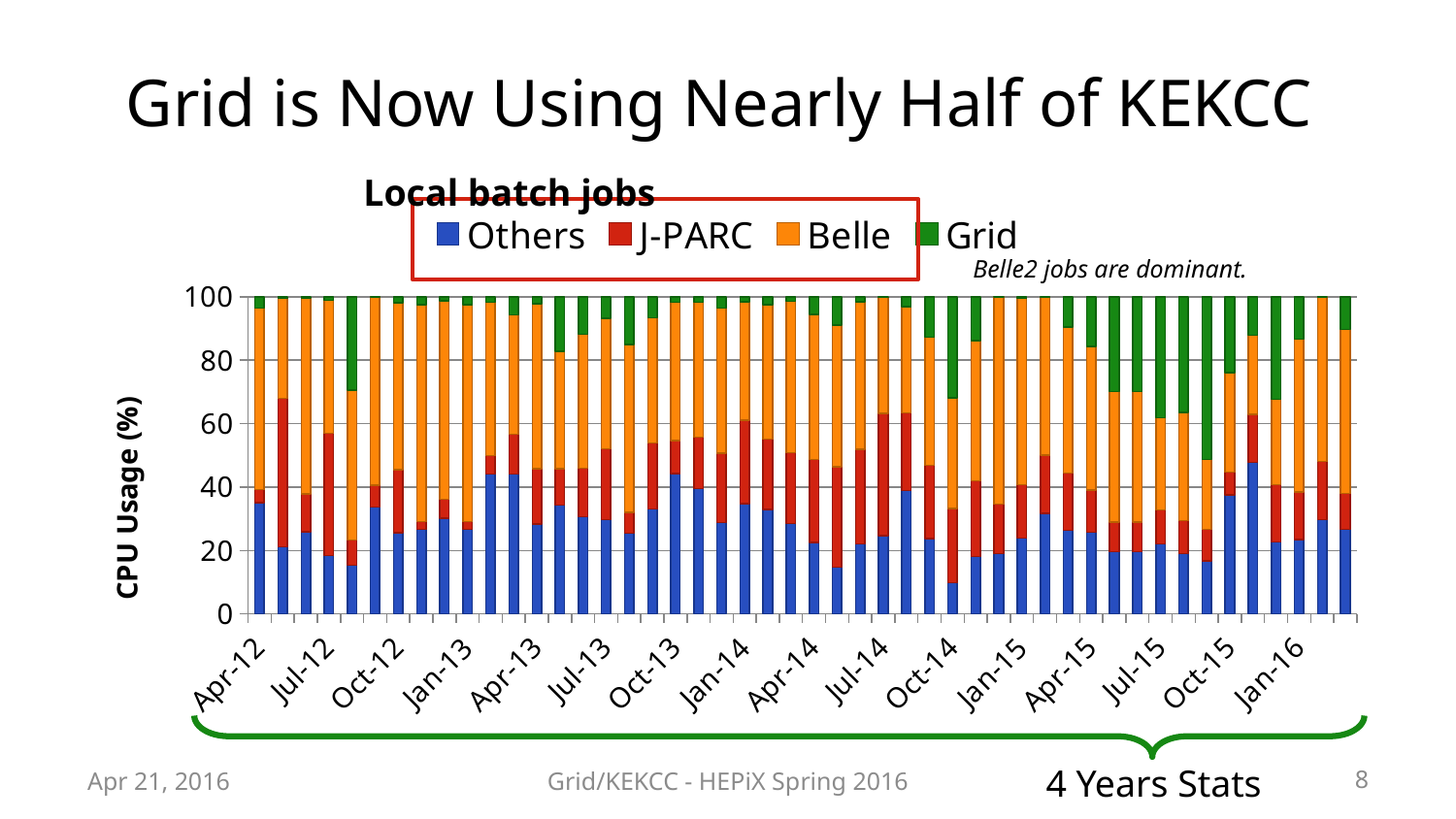
Does the Grid share generally rise or fall from Apr-12 to Jan-16? rise What is the title of the chart on the slide? Grid is Now Using Nearly Half of KEKCC How many series does the legend list? 4 What kind of chart is shown on the slide? stacked bar chart Is the Grid share in Oct-15 greater or less than 40? less What is the label of the vertical axis? CPU Usage (%) Is the value for Others in Apr-13 greater or less than 40? less Is the value for Others in Apr-12 greater or less than 40? less How many month labels are shown on the x axis? 16 Which is larger, the Others value in Apr-12 or the Others value in Oct-14? Apr-12